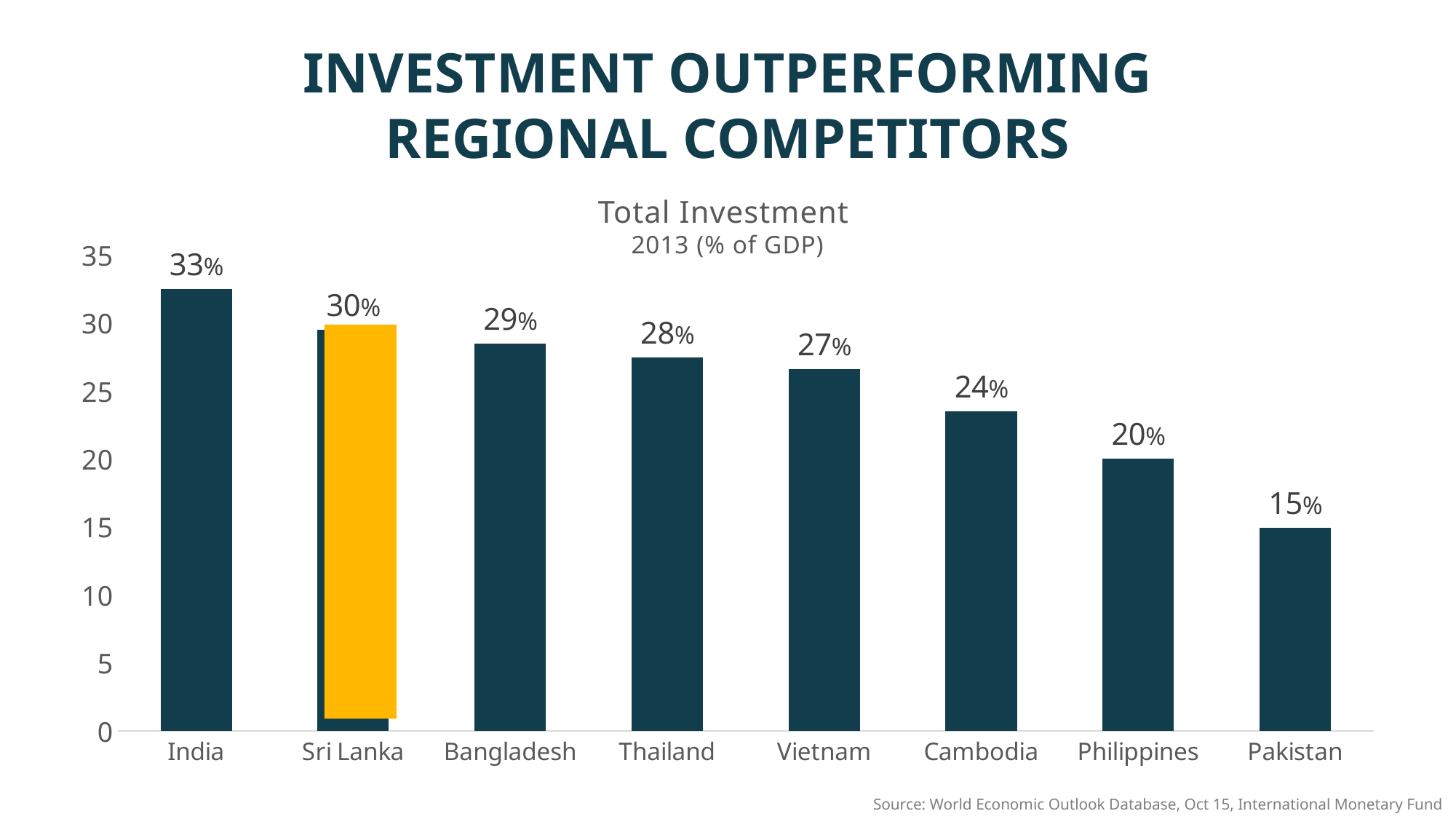
What is the total investment value for Sri Lanka? 30% What is the difference between India's and Sri Lanka's total investment values? 3% How many countries are shown in the chart? 8 What is the total investment value for Cambodia? 24% What is the difference between Philippines' and Pakistan's total investment values? 5% What kind of chart is shown on the slide? Bar chart Which country has the lowest total investment as % of GDP? Pakistan What is the total investment value for Pakistan? 15% Which country's bar is highlighted in a different colour (orange) from the others? Sri Lanka Which country has the highest total investment as % of GDP? India Which has a higher total investment value, Thailand or Vietnam? Thailand What is the total investment value for India? 33%